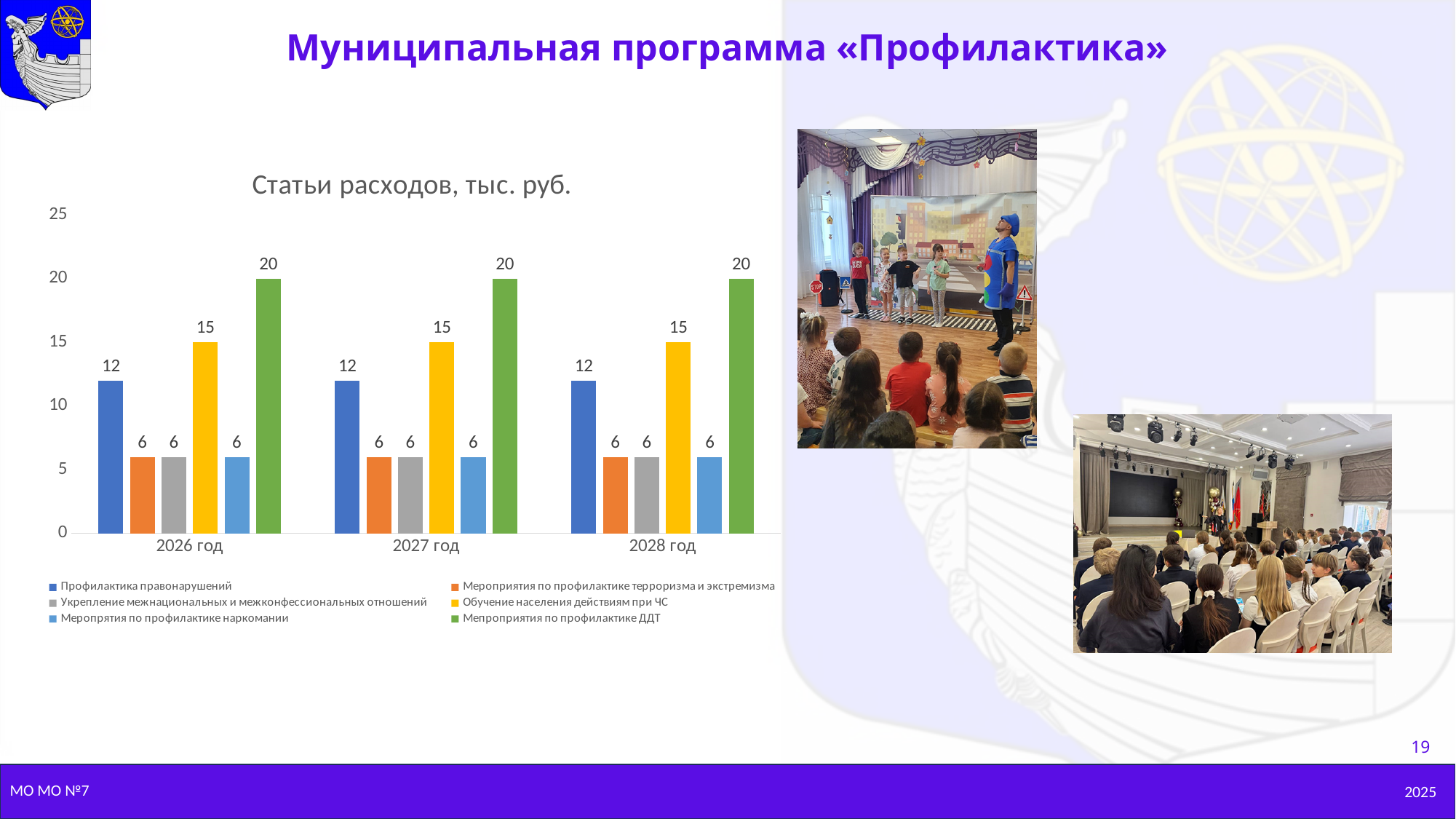
Is the value for «Мероприятия по профилактике терроризма и экстремизма» in 2027 год greater or less than 10? less How many year categories are shown on the x axis? 3 How many series does the legend list? 6 Which series has the highest value in 2027 год? Мероприятия по профилактике ДДТ What is the value for «Профилактика правонарушений» in 2026 год? 12 What kind of chart is shown on the slide? Bar chart Which is larger in 2026 год: «Обучение населения действиям при ЧС» or «Профилактика правонарушений»? Обучение населения действиям при ЧС What is the value for «Мероприятия по профилактике ДДТ» in 2028 год? 20 What is the difference between «Мероприятия по профилактике ДДТ» and «Профилактика правонарушений» in 2028 год? 8 What is the value for «Обучение населения действиям при ЧС» in 2027 год? 15 What is the title of the chart? Статьи расходов, тыс. руб. What is the value for «Мероприятия по профилактике наркомании» in 2026 год? 6